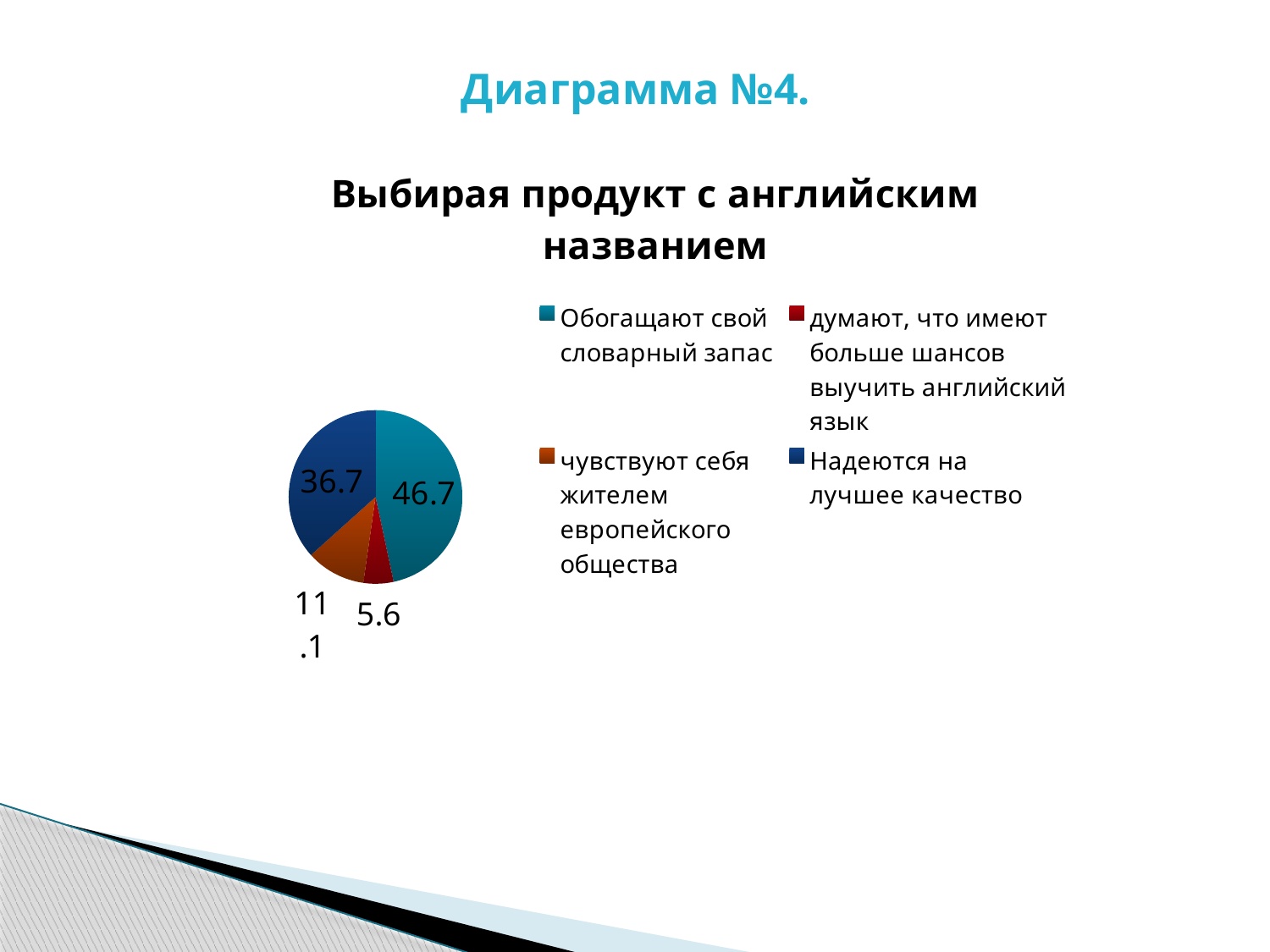
Which is larger: the value for "чувствуют себя жителем европейского общества" or the value for "думают, что имеют больше шансов выучить английский язык"? чувствуют себя жителем европейского общества Which category has the largest slice of the pie? Обогащают свой словарный запас What is the difference between the values for "Обогащают свой словарный запас" and "Надеются на лучшее качество"? 10 What is the title of the chart? Выбирая продукт с английским названием What is the value for "Надеются на лучшее качество"? 36.7 What is the value for "думают, что имеют больше шансов выучить английский язык"? 5.6 What is the value for "чувствуют себя жителем европейского общества"? 11.1 Which category has the smallest slice of the pie? думают, что имеют больше шансов выучить английский язык How many entries does the legend list? 4 How many slices does the pie chart have? 4 What is the value for "Обогащают свой словарный запас"? 46.7 What kind of chart is shown on the slide? pie chart